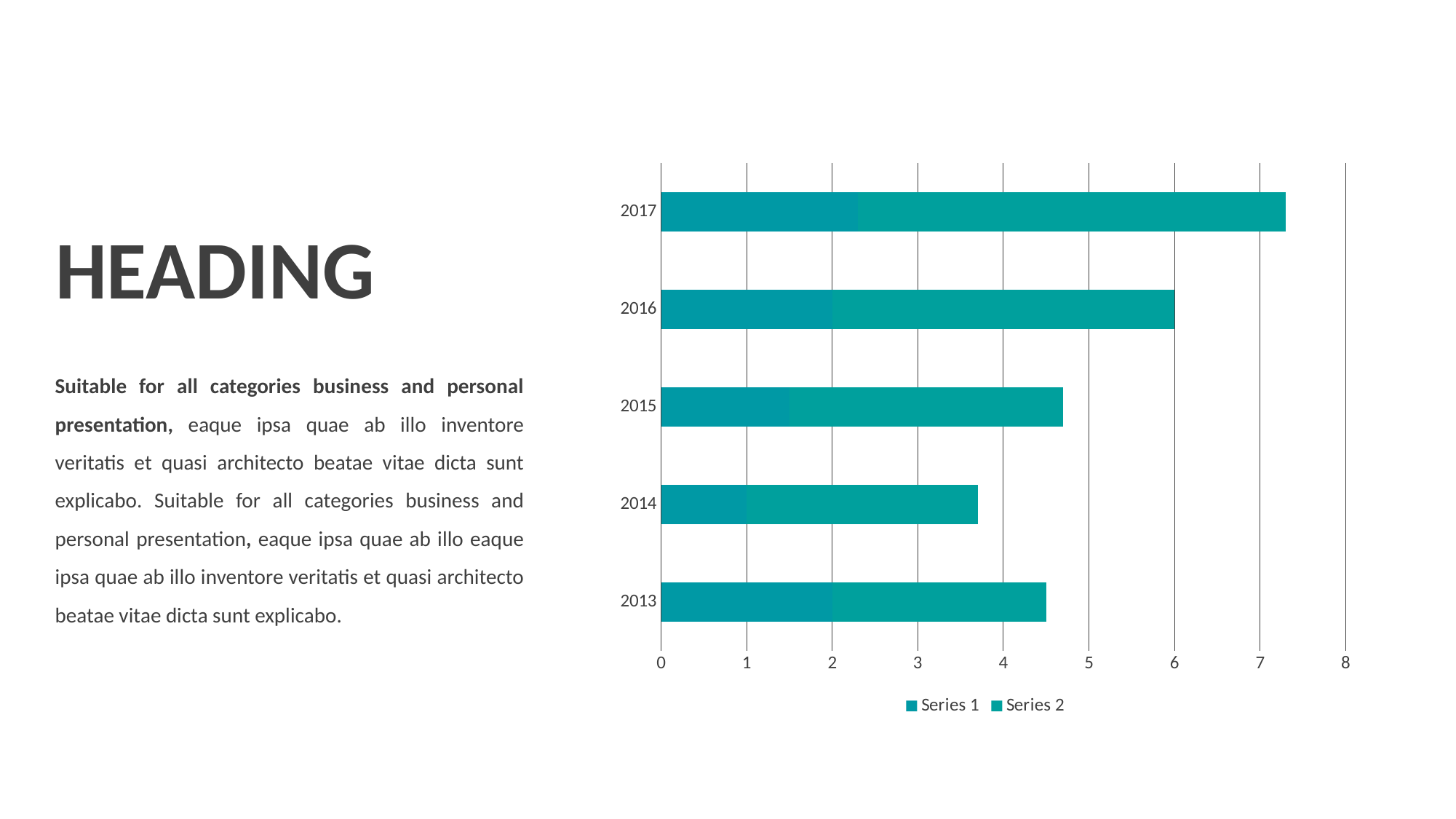
Which year has the shortest total bar? 2014 Is the total bar length for 2015 greater or less than 5? less Is the total bar length for 2017 greater or less than 7? greater Which year has the larger total bar, 2016 or 2015? 2016 Which year has the larger total bar, 2013 or 2014? 2013 What kind of chart is shown on the slide? bar chart Is the total bar length for 2014 greater or less than 4? less Which year has the longest total bar? 2017 How many series does the legend list? 2 How many categories (years) are plotted on the chart? 5 What are the names of the two series in the legend? Series 1 and Series 2